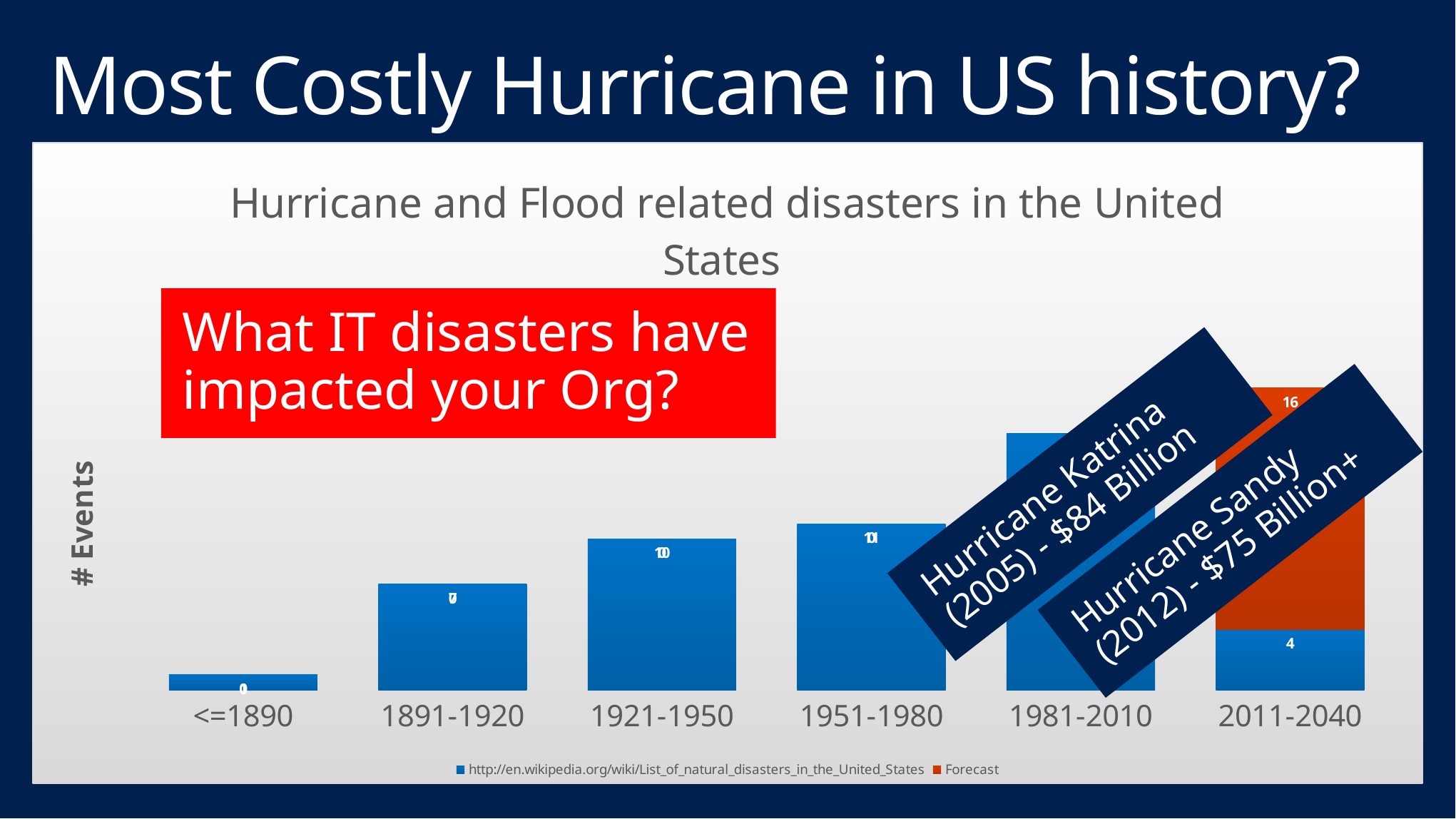
Which period has the tallest bar overall? 2011-2040 What is the Forecast value for the 2011-2040 period? 16 What is the value of the blue (non-forecast) series for the 2011-2040 period? 4 What kind of chart is shown on the slide? bar chart How many series does the legend list? 2 What is the total height of the stacked bar for 2011-2040? 20 How many time-period categories are shown on the x axis? 6 Which period has more events, 1891-1920 or 1921-1950? 1921-1950 What is the label on the y axis? # Events What is the number of events for the 1891-1920 period? 7 Which period has the lowest number of events? <=1890 What is the number of events for the 1921-1950 period? 10